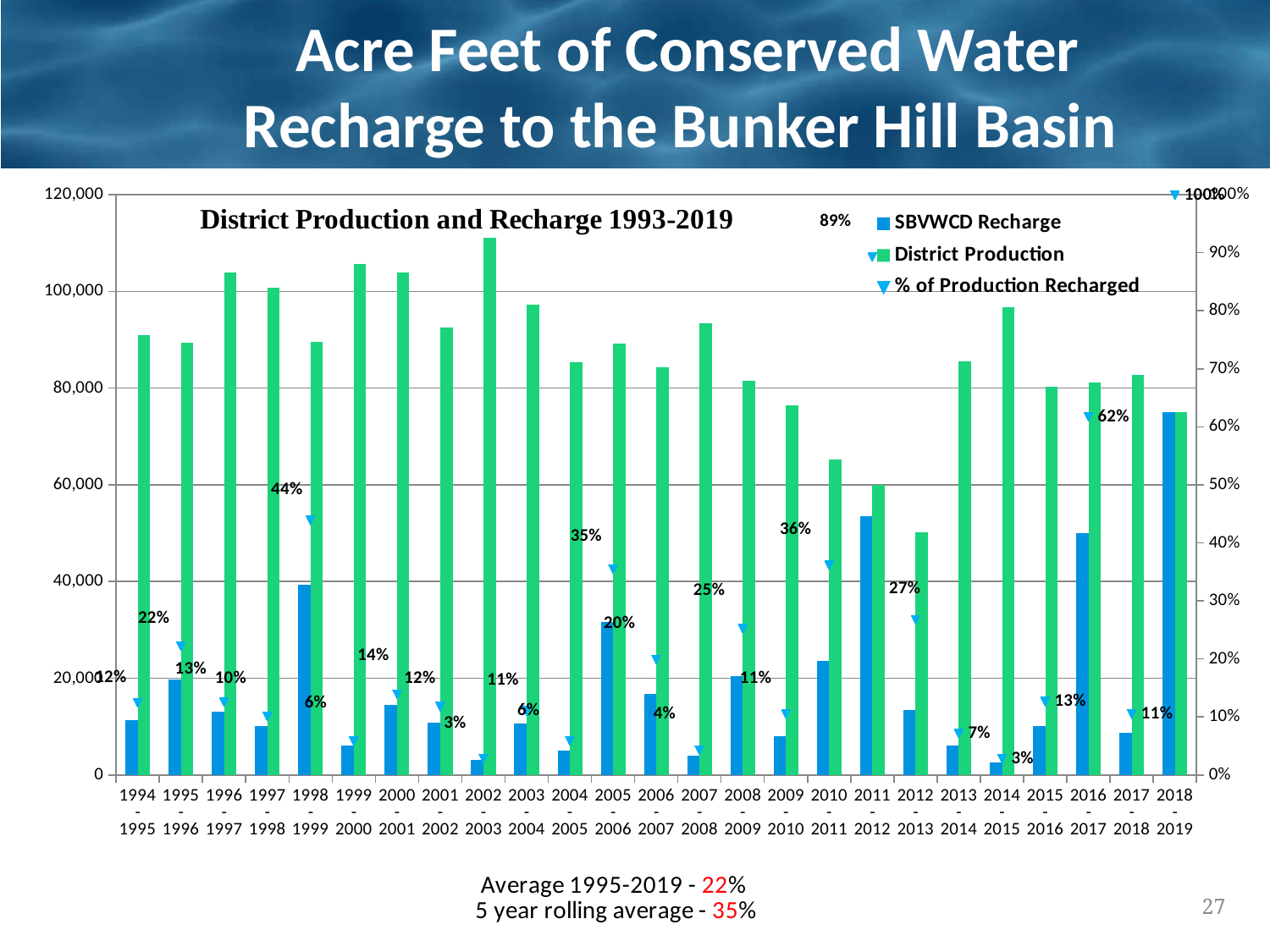
Which year period has the highest SBVWCD Recharge? 2018-2019 What is the title printed inside the chart area? District Production and Recharge 1993-2019 How many series does the chart legend list? 3 Which year period has the highest District Production? 2002-2003 What kind of chart is shown on the slide? combination bar and line chart Is the District Production for 2002-2003 greater or less than 100,000? greater Which year period has the highest % of Production Recharged? 2018-2019 Is the District Production for 2012-2013 greater or less than 60,000? less What is the % of Production Recharged for 2016-2017? 62% How many year periods are shown along the x axis of the chart? 25 Which is larger, the SBVWCD Recharge for 2005-2006 or for 2016-2017? 2016-2017 What is the % of Production Recharged for 2018-2019? 100%